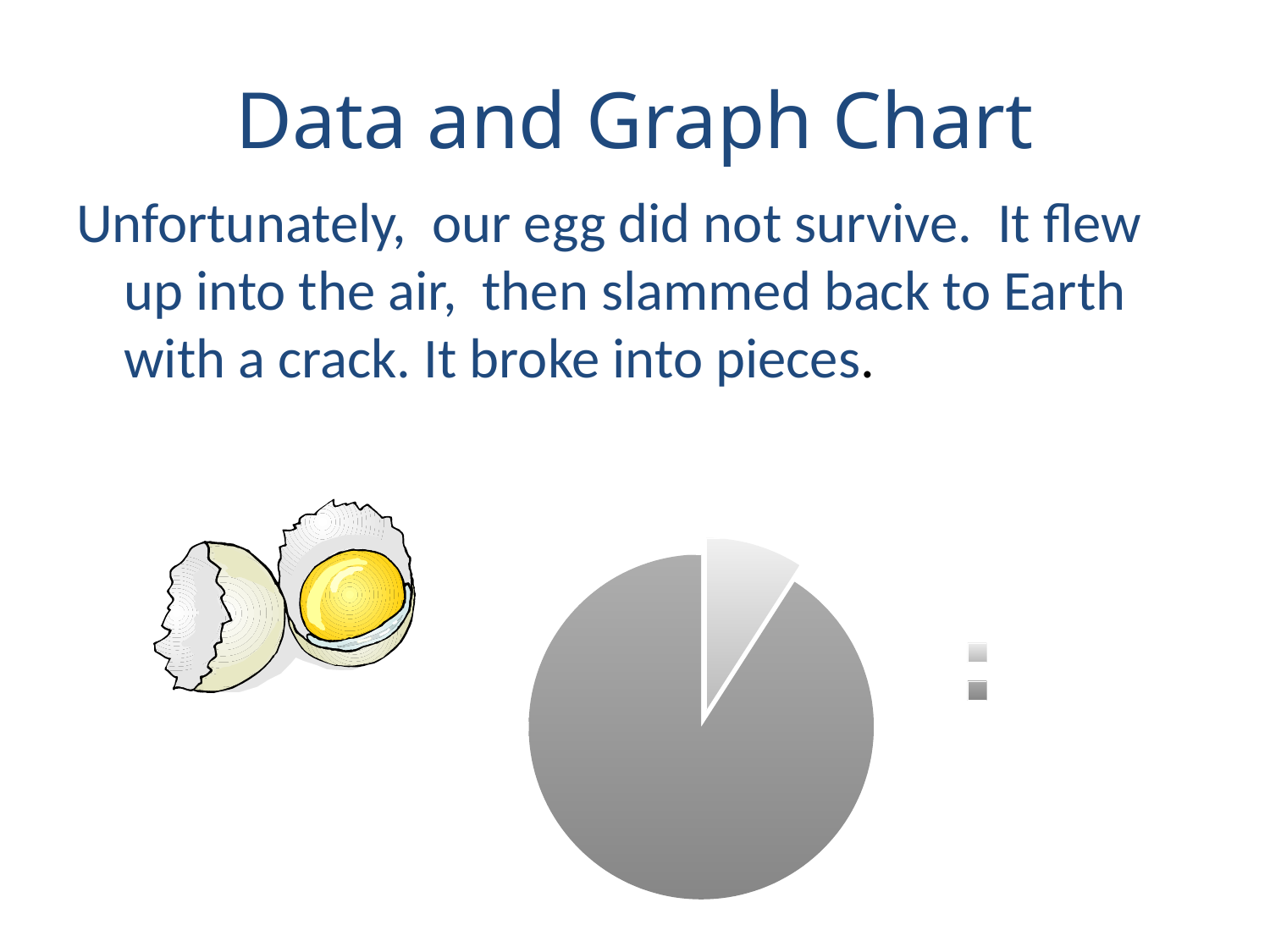
Does the dark grey slice take up more or less than half of the pie chart? more Which slice of the pie chart is larger, the dark grey slice or the light grey slice? the dark grey slice How many entries does the pie chart's legend list? 2 How many slices does the pie chart have? 2 What is the title of the slide containing the pie chart? Data and Graph Chart What kind of chart is shown on the slide? pie chart Which slice of the pie chart is the smallest? the light grey slice Does the pie chart display any data labels or percentages on its slices? No